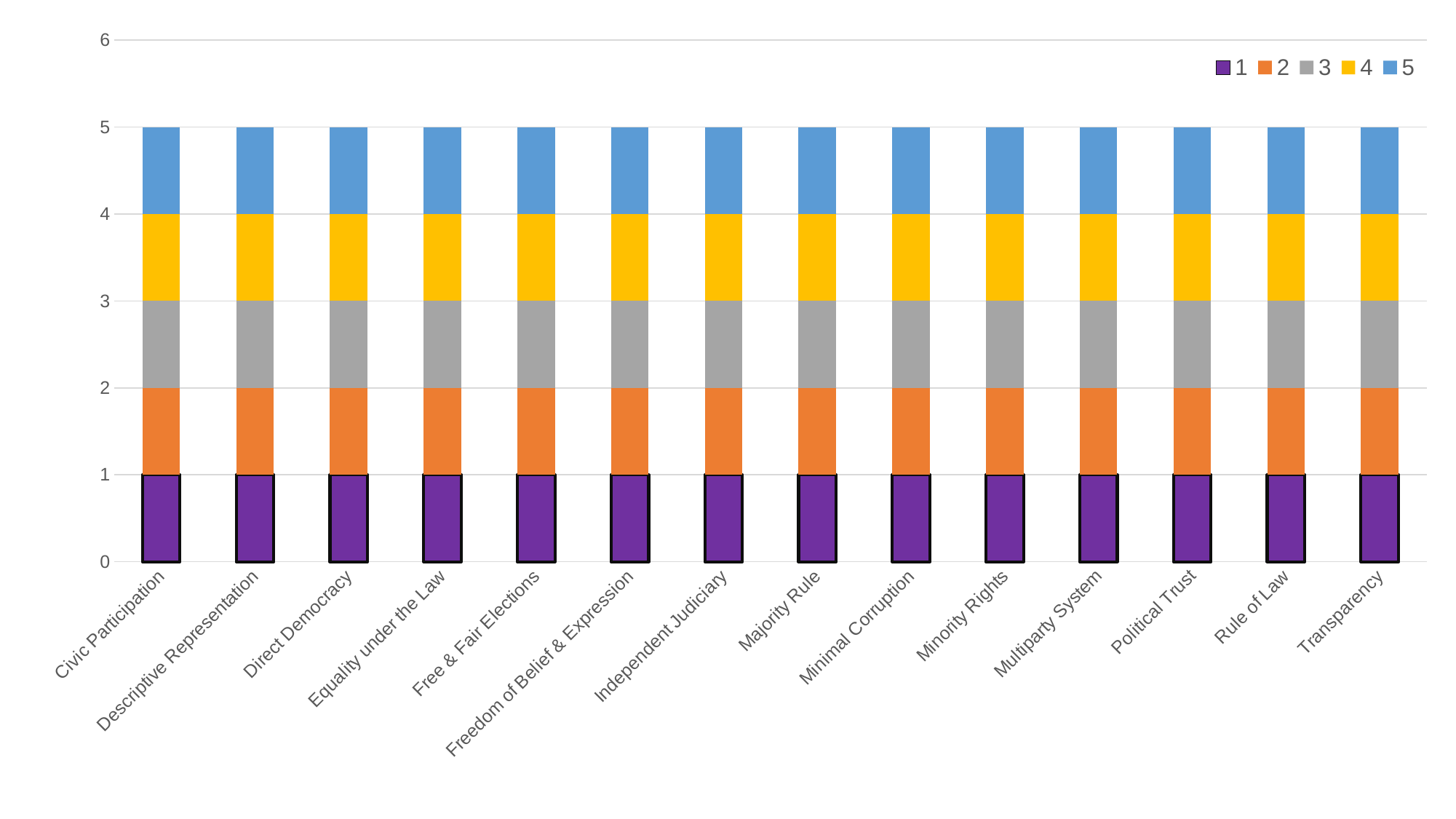
Is the total for Majority Rule greater or less than 6? less What is the first category label on the x axis? Civic Participation How many series does the legend list? 5 How many categories are shown along the x axis? 14 Do the bar totals rise, fall, or stay the same across the categories from left to right? stay the same Is the total for Rule of Law greater or less than 4? greater What kind of chart is shown on the slide? stacked bar chart What is the highest value shown on the y axis? 6 What is the total height of the stacked bar for Civic Participation? 5 Which series is shown in purple according to the legend? 1 What is the total height of the stacked bar for Transparency? 5